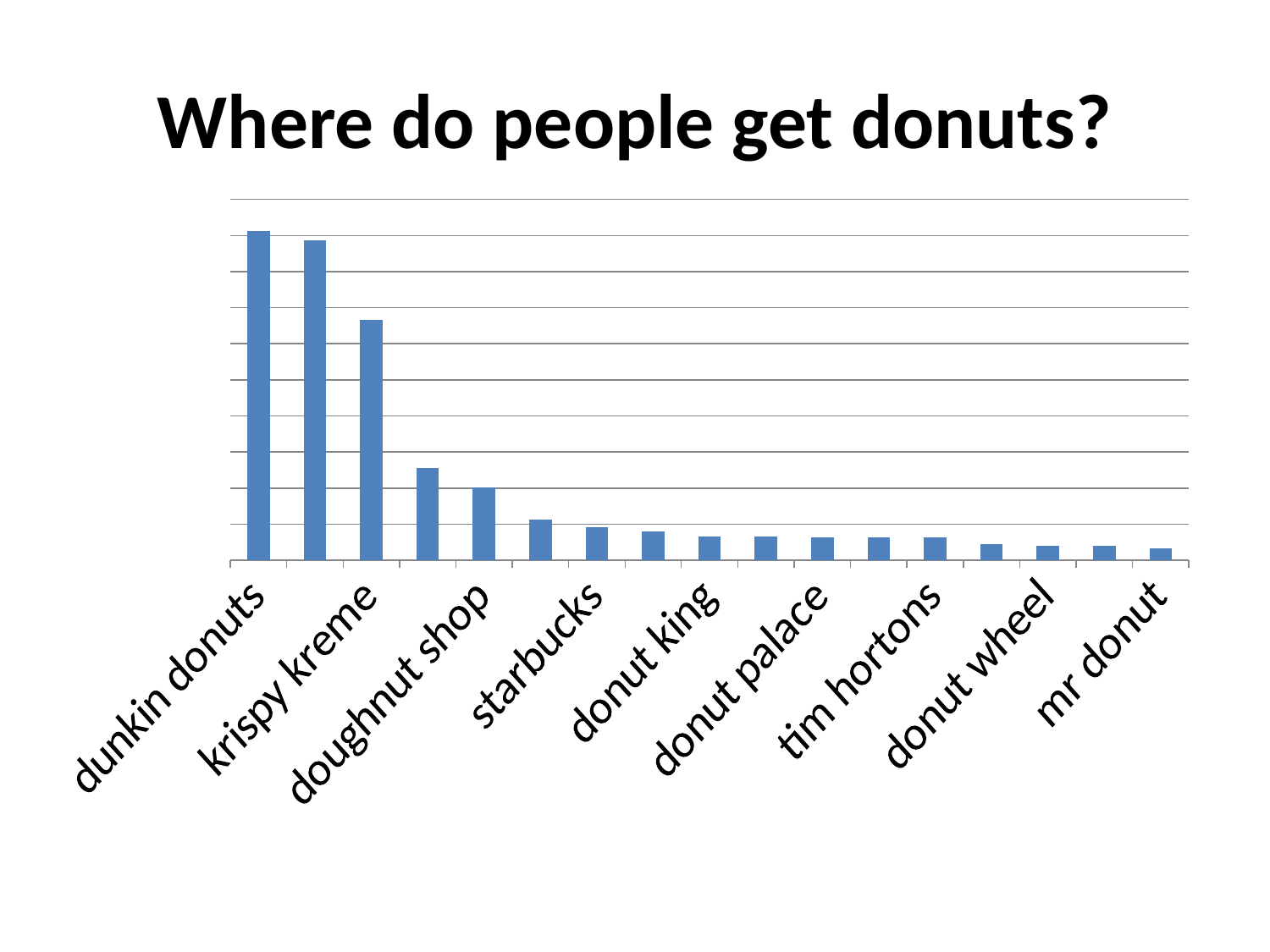
Which is larger, the value for dunkin donuts or the value for krispy kreme? dunkin donuts Do the bar values rise or fall from left to right along the x axis? fall Which is larger, the value for krispy kreme or the value for starbucks? krispy kreme What kind of chart is shown on the slide? bar chart How many bars are plotted in the chart? 17 What colour are the bars in the chart? blue What is the title of the chart? Where do people get donuts? Which is larger, the value for dunkin donuts or the value for tim hortons? dunkin donuts Which category has the highest bar? dunkin donuts